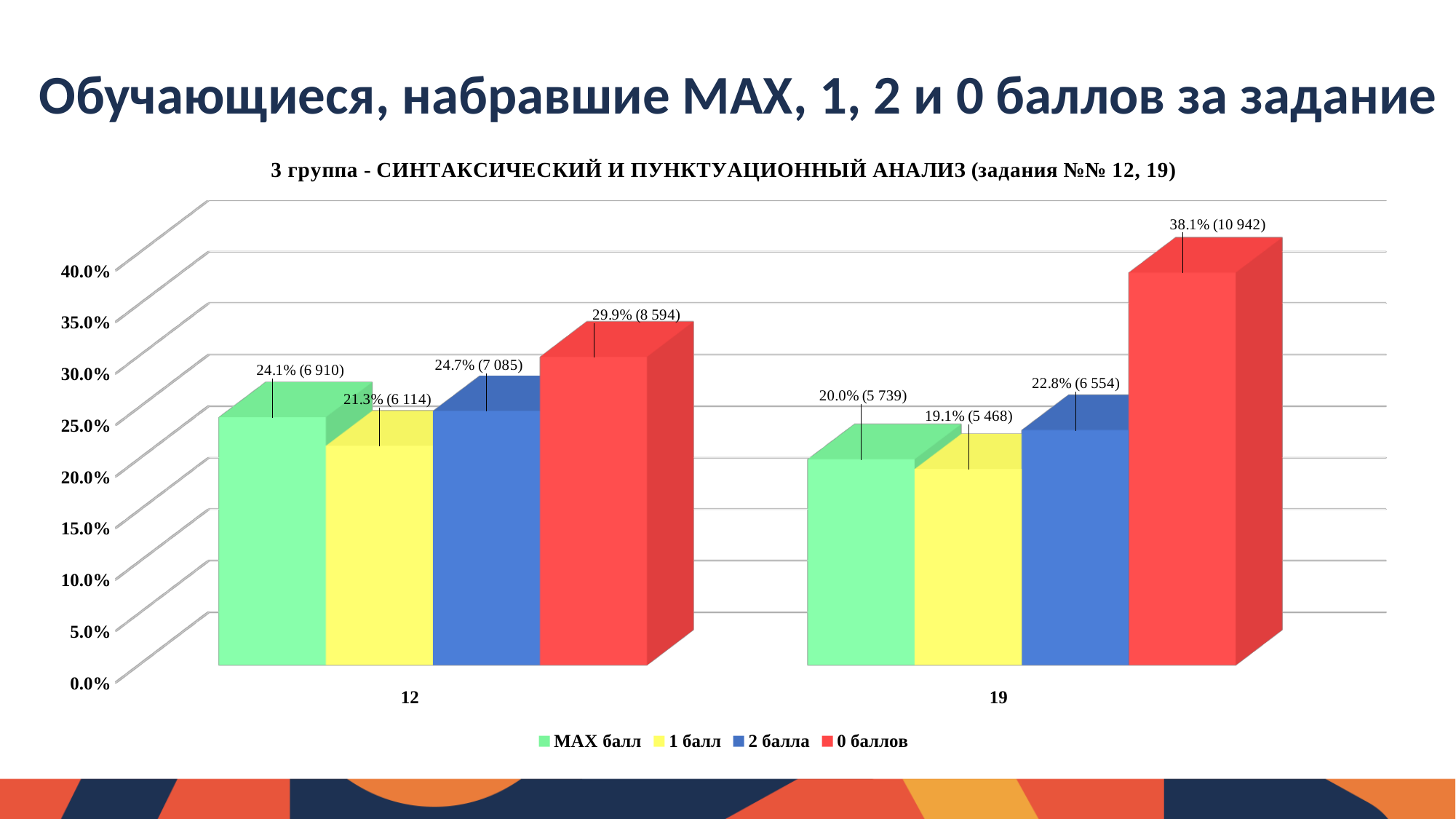
What percentage of students scored 0 баллов on task 19? 38.1% What colour represents the 0 баллов series in the chart? red Is the value for 0 баллов on task 19 greater or less than 35.0%? greater Which is larger: the MAX балл value for task 12 or the MAX балл value for task 19? task 12 What kind of chart is shown on the slide? bar chart Which series has the lowest value for task 12? 1 балл What is the difference in percentage between 0 баллов on task 19 and 0 баллов on task 12? 8.2% Which series has the highest value for task 19? 0 баллов How many series does the legend list? 4 How many students scored MAX балл on task 12, according to the data label? 6 910 What percentage of students scored 2 балла on task 12? 24.7% What is the data label for 1 балл on task 19? 19.1% (5 468)